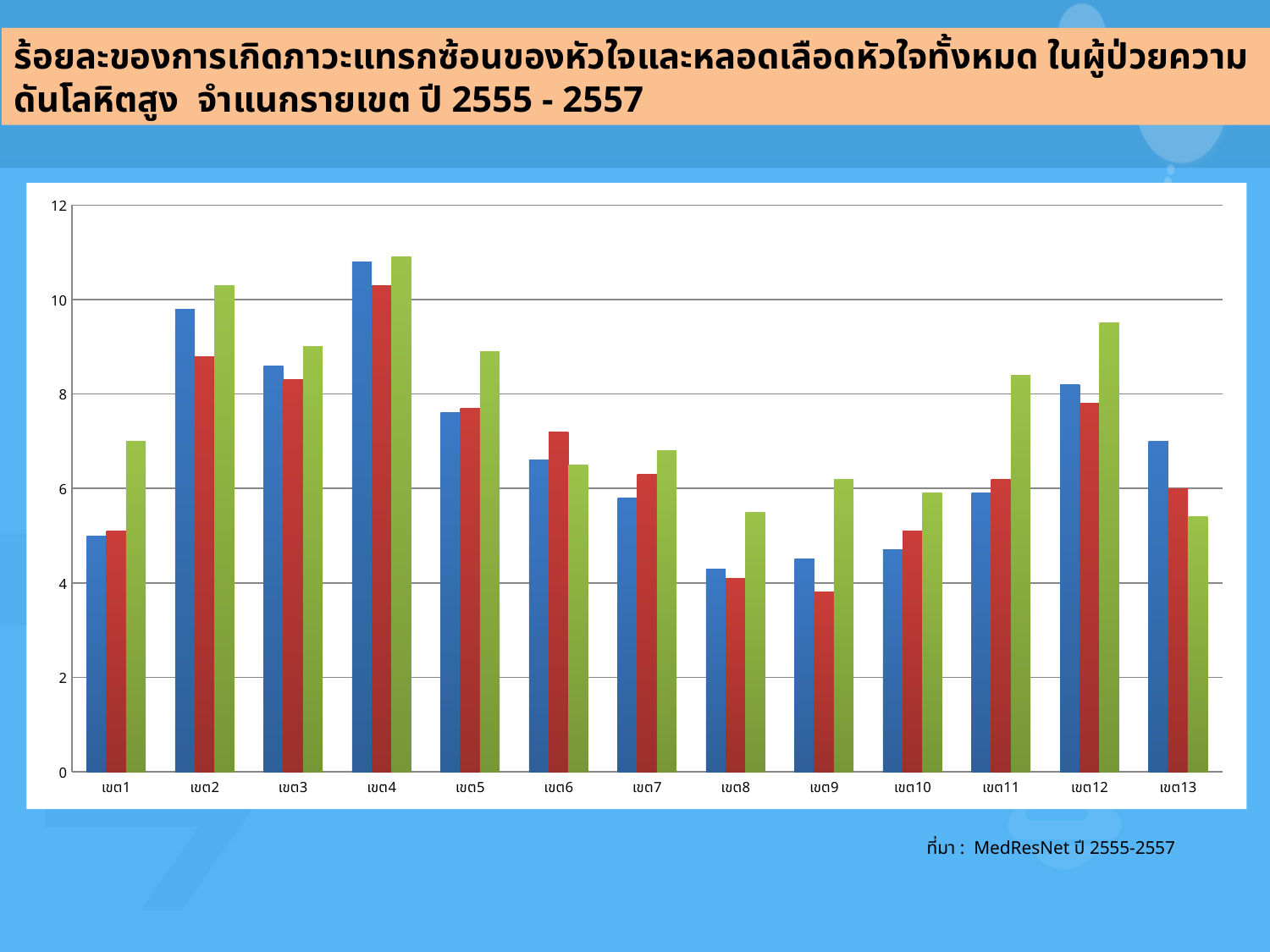
Which is taller, the blue bar for เขต2 or the blue bar for เขต3? เขต2 How many เขต categories are shown on the x axis? 13 Which เขต has the tallest bars in the chart? เขต4 Is the green bar for เขต12 greater or less than 8? greater What source is cited below the chart? MedResNet ปี 2555-2557 Do the blue bars rise or fall from เขต4 to เขต8? fall Which is taller, the green bar for เขต11 or the green bar for เขต12? เขต12 Is the blue bar for เขต1 greater or less than 6? less Is the green bar for เขต8 greater or less than 6? less What kind of chart is shown on the slide? bar chart